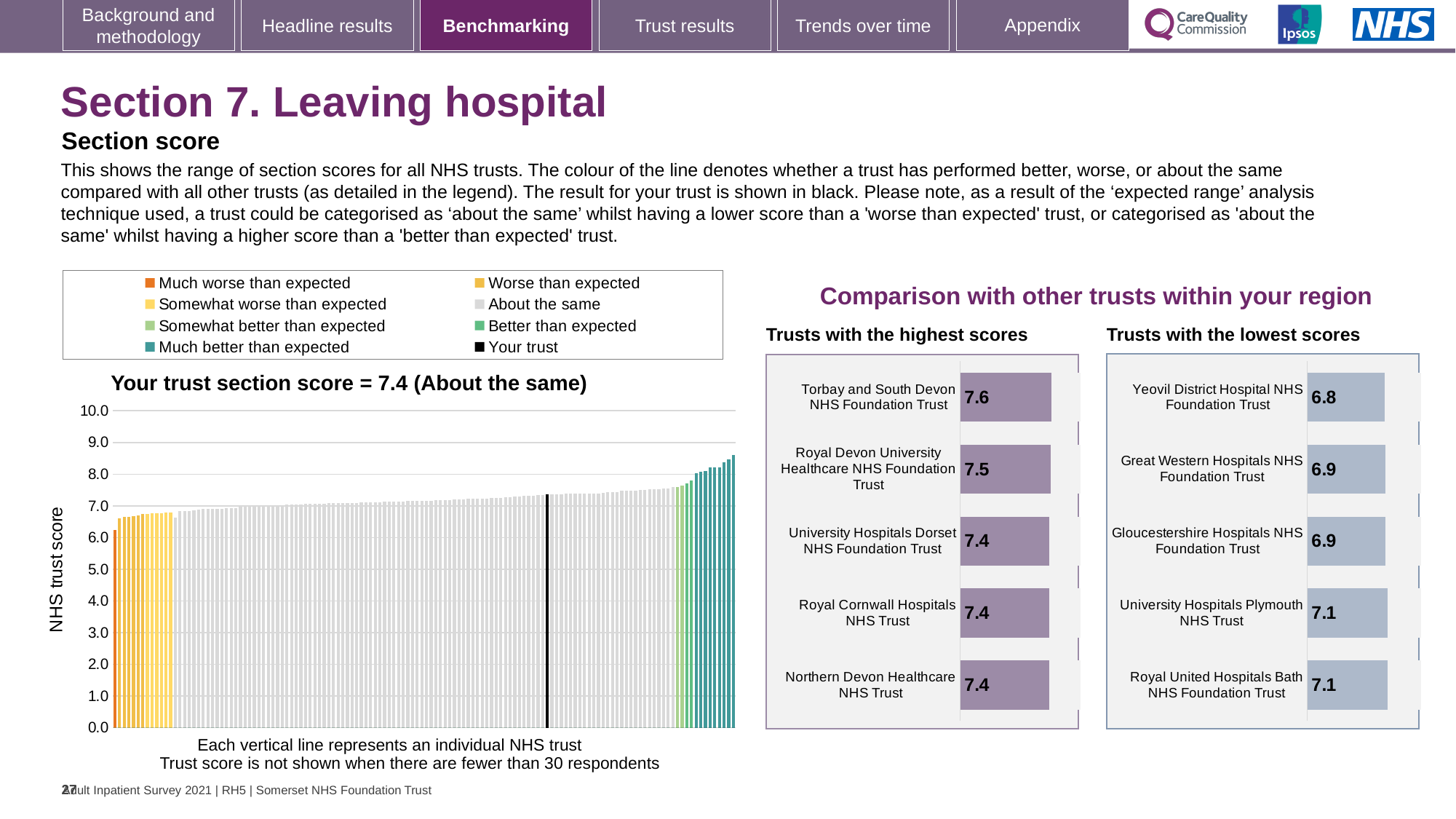
In the 'Trusts with the lowest scores' chart, what is the difference between the scores of Royal United Hospitals Bath NHS Foundation Trust and Yeovil District Hospital NHS Foundation Trust? 0.3 How many trusts are shown in the 'Trusts with the lowest scores' chart? 5 In the 'Trusts with the highest scores' chart, what is the difference between the scores of Torbay and South Devon NHS Foundation Trust and Royal Devon University Healthcare NHS Foundation Trust? 0.1 In the main chart on the left, do the trust scores rise or fall from left to right? rise In the main chart on the left, what is the section score for your trust? 7.4 In the 'Trusts with the highest scores' chart, which has the larger score: Torbay and South Devon NHS Foundation Trust or Northern Devon Healthcare NHS Trust? Torbay and South Devon NHS Foundation Trust In the 'Trusts with the highest scores' chart, what is the score for Torbay and South Devon NHS Foundation Trust? 7.6 In the 'Trusts with the lowest scores' chart, which trust has the lowest score? Yeovil District Hospital NHS Foundation Trust In the 'Trusts with the lowest scores' chart, what is the score for Yeovil District Hospital NHS Foundation Trust? 6.8 In the 'Trusts with the highest scores' chart, what is the score for Royal Devon University Healthcare NHS Foundation Trust? 7.5 In the 'Trusts with the highest scores' chart, which trust has the highest score? Torbay and South Devon NHS Foundation Trust In the 'Trusts with the lowest scores' chart, what is the score for University Hospitals Plymouth NHS Trust? 7.1